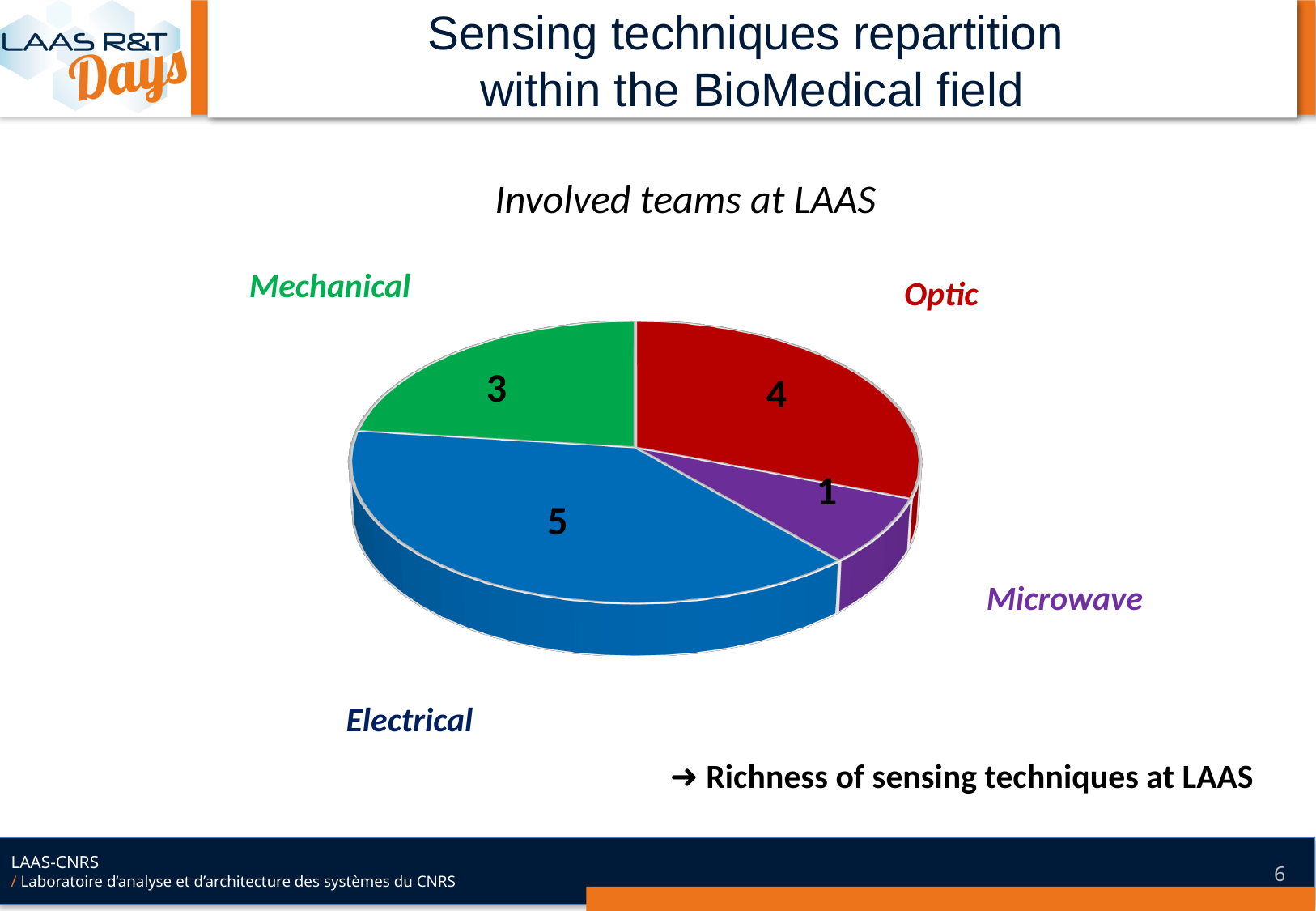
What kind of chart is shown on the slide? pie chart Which is larger, the value for Optic or the value for Mechanical? Optic What is the value for Optic in the pie chart? 4 What is the value for Microwave in the pie chart? 1 Which sensing technique has the largest slice in the pie chart? Electrical What is the difference between the values for Optic and Mechanical? 1 How many slices does the pie chart have? 4 What colour is the Microwave slice in the pie chart? purple What is the value for Electrical in the pie chart? 5 What is the difference between the values for Electrical and Microwave? 4 What is the value for Mechanical in the pie chart? 3 Which sensing technique has the smallest slice in the pie chart? Microwave